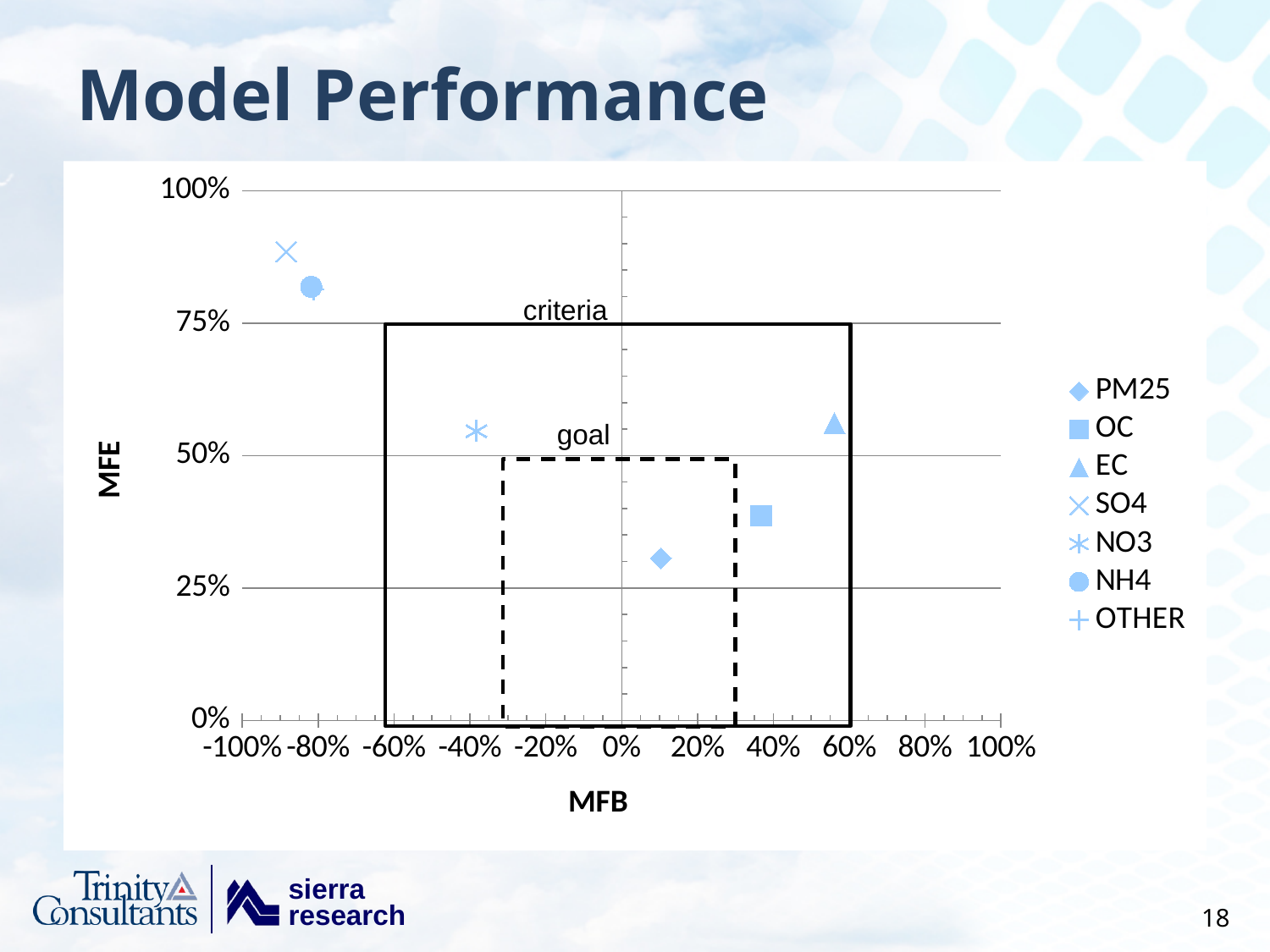
What are the labels of the x axis and y axis of the chart? MFB and MFE What kind of chart is shown on the slide? scatter chart Is the MFB value for EC greater or less than 40%? greater Which series has the lowest MFE value? PM25 Which series has the lowest MFB value? SO4 Which series has a higher MFE value, EC or OC? EC Is the MFE value for PM25 greater or less than 50%? less Which series has the highest MFE value? SO4 Which series has the highest MFB value? EC Is the MFE value for NH4 greater or less than 75%? greater How many series does the legend list? 7